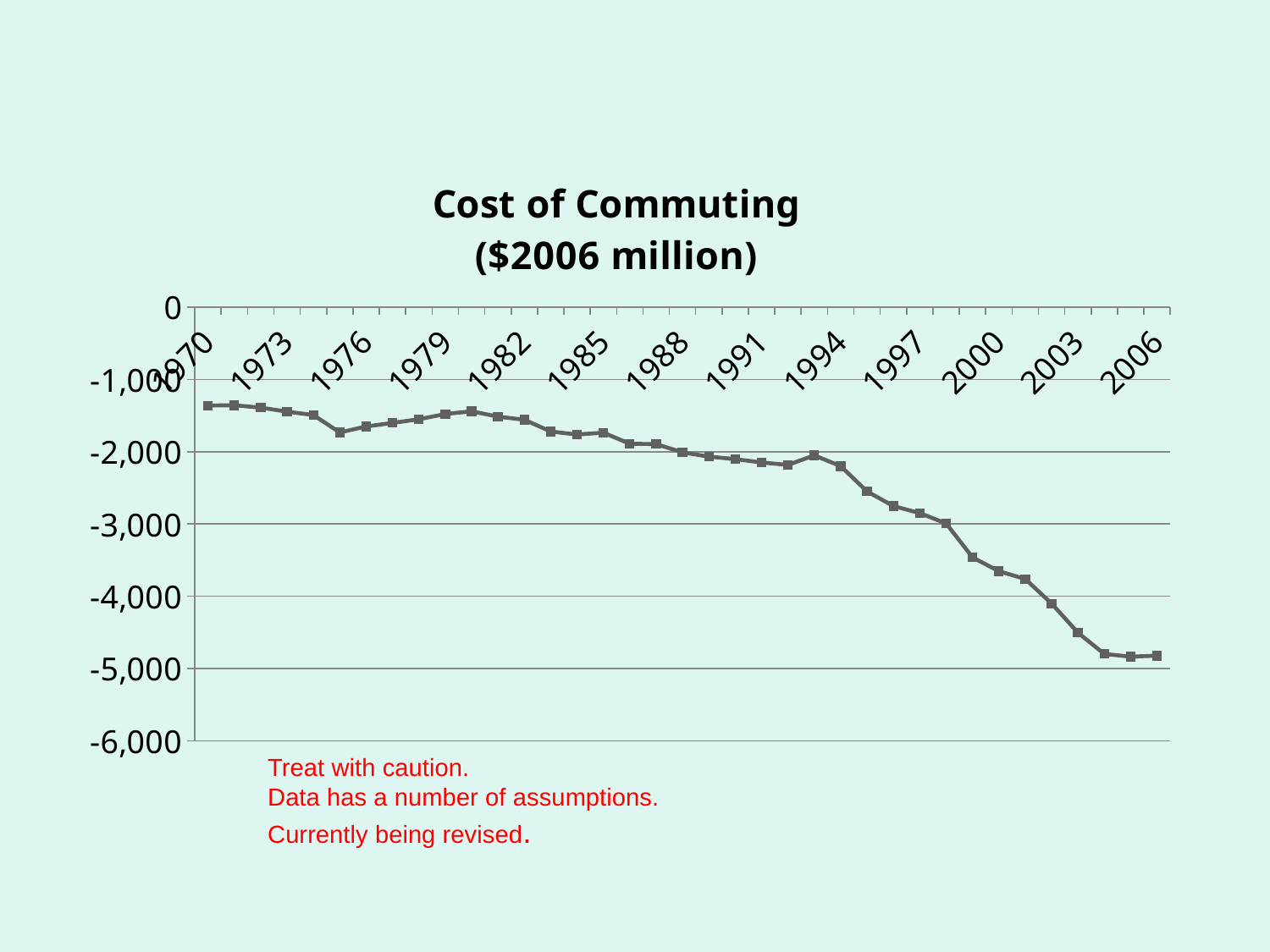
Is the value for 2006 greater or less than -4,000? less How many lines (series) are plotted on the chart? 1 Overall, do the values rise or fall from 1970 to 2006? fall Is the value for 1985 greater or less than -2,000? greater Is the value for 1994 higher or lower on the chart than the value for 2000? higher What is the title of the chart? Cost of Commuting ($2006 million) What is the lowest value shown on the y axis? -6,000 Is the value for 1970 greater or less than -2,000? greater What kind of chart is shown on the slide? line chart Is the value for 1976 higher or lower on the chart than the value for 1982? lower How many year labels are shown along the x axis? 13